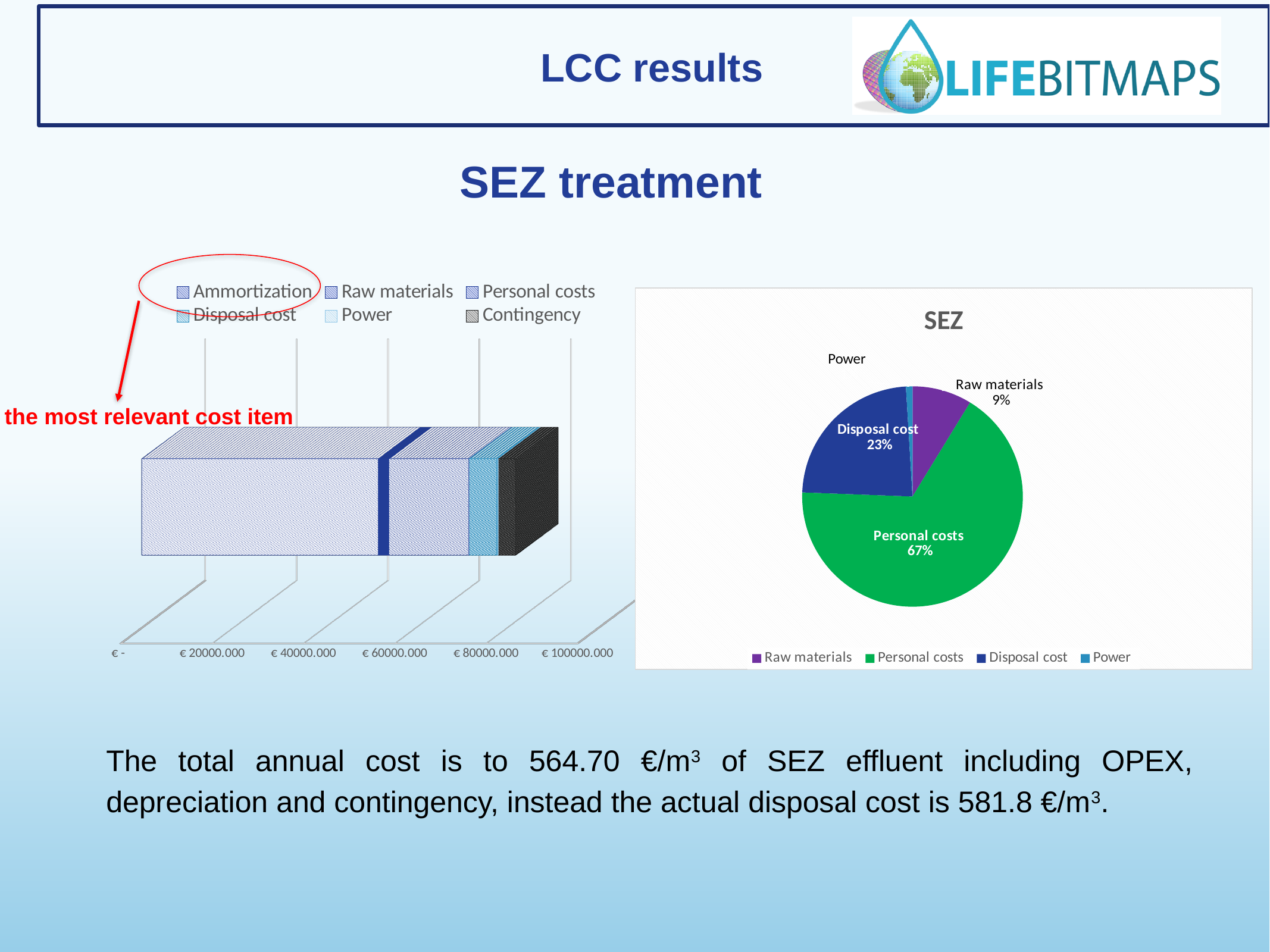
In the pie chart titled SEZ, what share does Personal costs have? 67% In the chart on the left of the slide, which series forms the largest segment of the bar? Ammortization What kind of chart is the chart on the right of the slide? Pie chart In the pie chart titled SEZ, what share does Disposal cost have? 23% In the pie chart titled SEZ, how many percentage points larger is Personal costs than Disposal cost? 44 In the chart on the left of the slide, how many series does the legend list? 6 In the pie chart titled SEZ, which category has the smallest slice? Power What kind of chart is the chart on the left of the slide? Bar chart In the pie chart titled SEZ, which category has the largest slice? Personal costs In the pie chart titled SEZ, what share does Raw materials have? 9% In the pie chart titled SEZ, how many categories does the legend list? 4 In the pie chart titled SEZ, which is larger, Disposal cost or Raw materials? Disposal cost